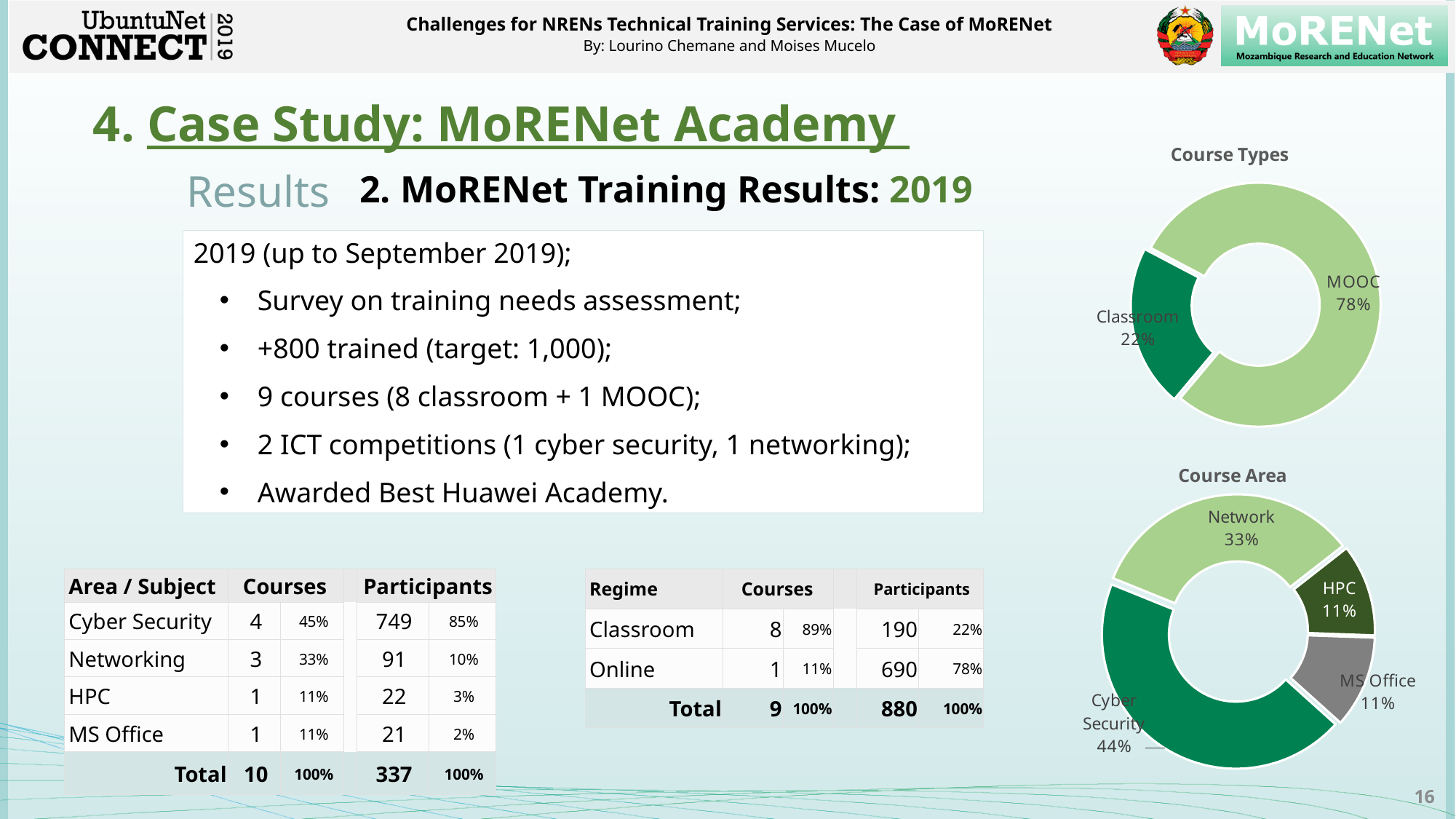
In the Course Area chart, what share does Cyber Security have? 44% In the Course Area chart, what share does Network have? 33% In the Course Types chart, what is the difference in percentage points between MOOC and Classroom? 56 In the Course Types chart, what share does MOOC have? 78% In the Course Types chart, what share does Classroom have? 22% In the Course Area chart, which slice is the largest? Cyber Security In the Course Types chart, how many slices are there? 2 In the Course Area chart, which is larger, Network or MS Office? Network In the Course Area chart, how many slices are there? 4 In the Course Area chart, what share does HPC have? 11% In the Course Types chart, which slice is the largest? MOOC What kind of chart is the Course Types chart? Donut (pie) chart